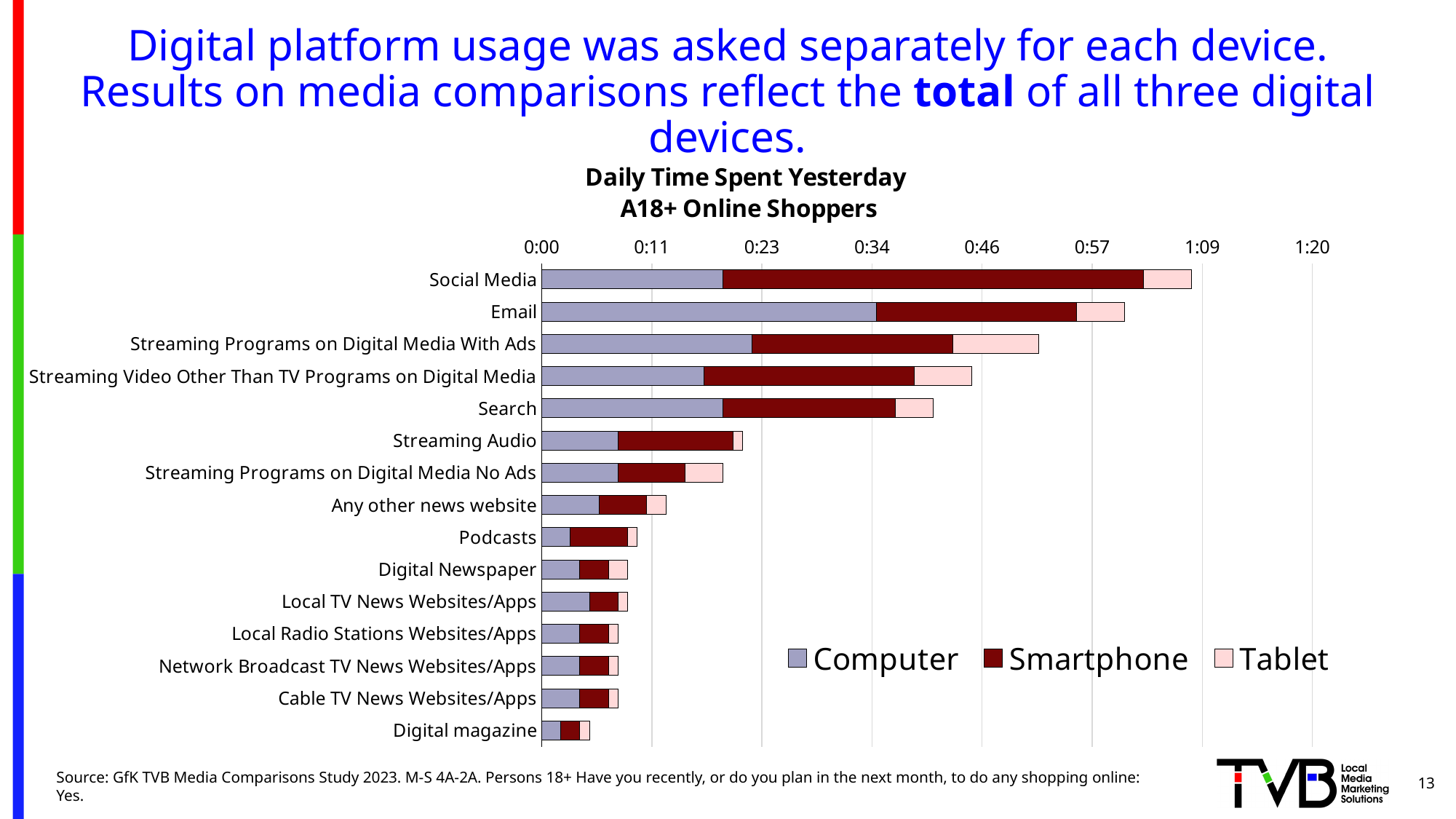
Is the total bar for Search greater or less than 0:46? less What kind of chart is shown on the slide? Stacked bar chart Is the Computer segment for Email greater or less than 0:23? greater Which has a larger Computer segment, Email or Social Media? Email How many series does the legend list? 3 What is the title of the chart? Daily Time Spent Yesterday A18+ Online Shoppers Which has a larger total daily time spent, Social Media or Email? Social Media Which category has the shortest total bar? Digital magazine Is the total bar for Streaming Audio greater or less than 0:23? less Which category has the longest total bar? Social Media How many categories (media types) are plotted on the chart? 15